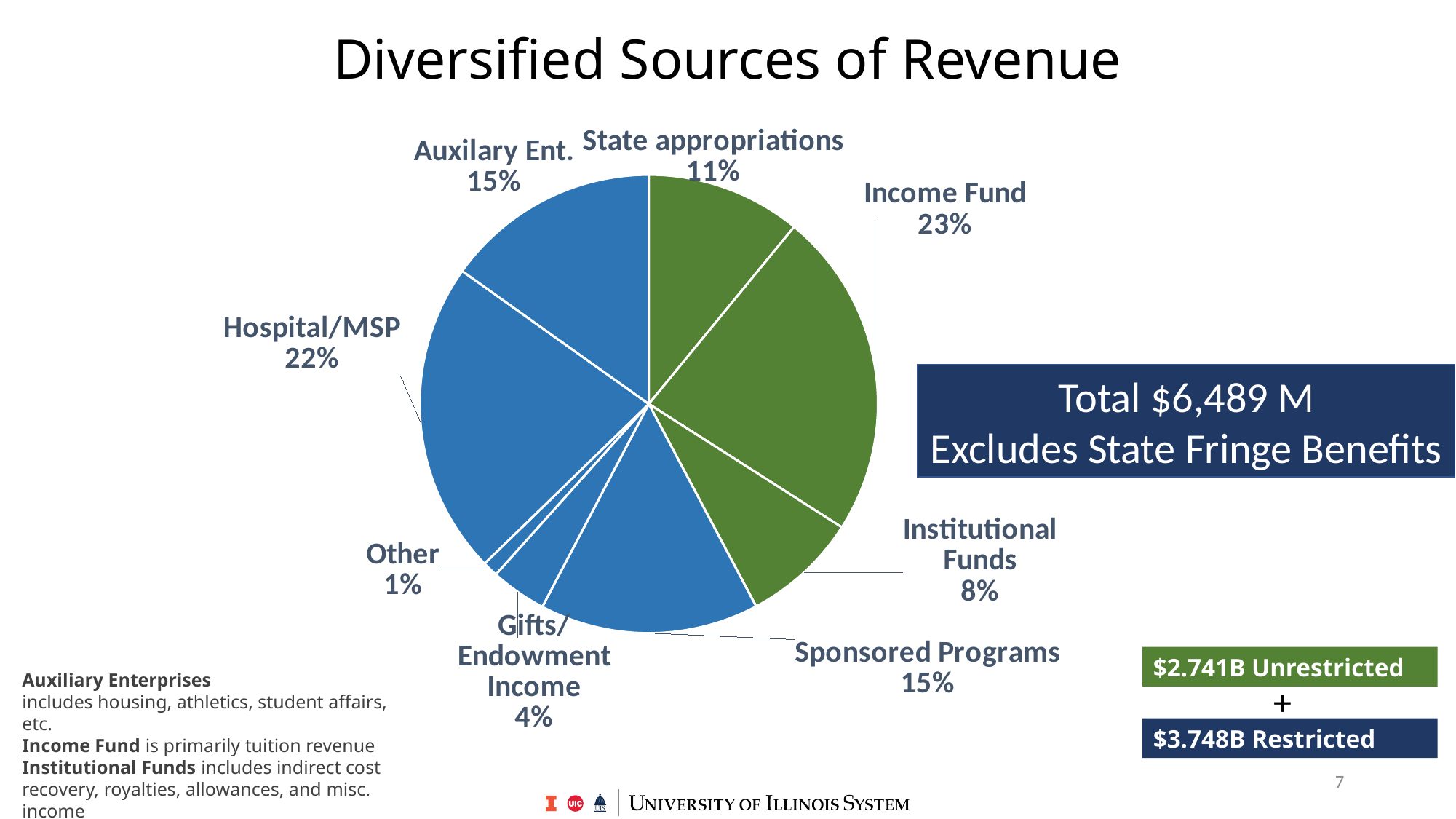
What share of revenue is State appropriations? 11% What percentage of revenue comes from Gifts/Endowment Income? 4% How many slices does the pie chart have? 8 What is the combined share of Auxilary Ent. and Sponsored Programs? 30% Which is larger, the share for Hospital/MSP or the share for Sponsored Programs? Hospital/MSP What percentage of revenue is from Hospital/MSP? 22% What kind of chart is shown on the slide? Pie chart What total revenue amount is stated next to the chart? $6,489 M Which revenue source has the smallest share of the pie? Other What share of revenue comes from the Income Fund? 23% What is the difference in percentage points between Income Fund and Institutional Funds? 15 Which revenue source has the largest share of the pie? Income Fund